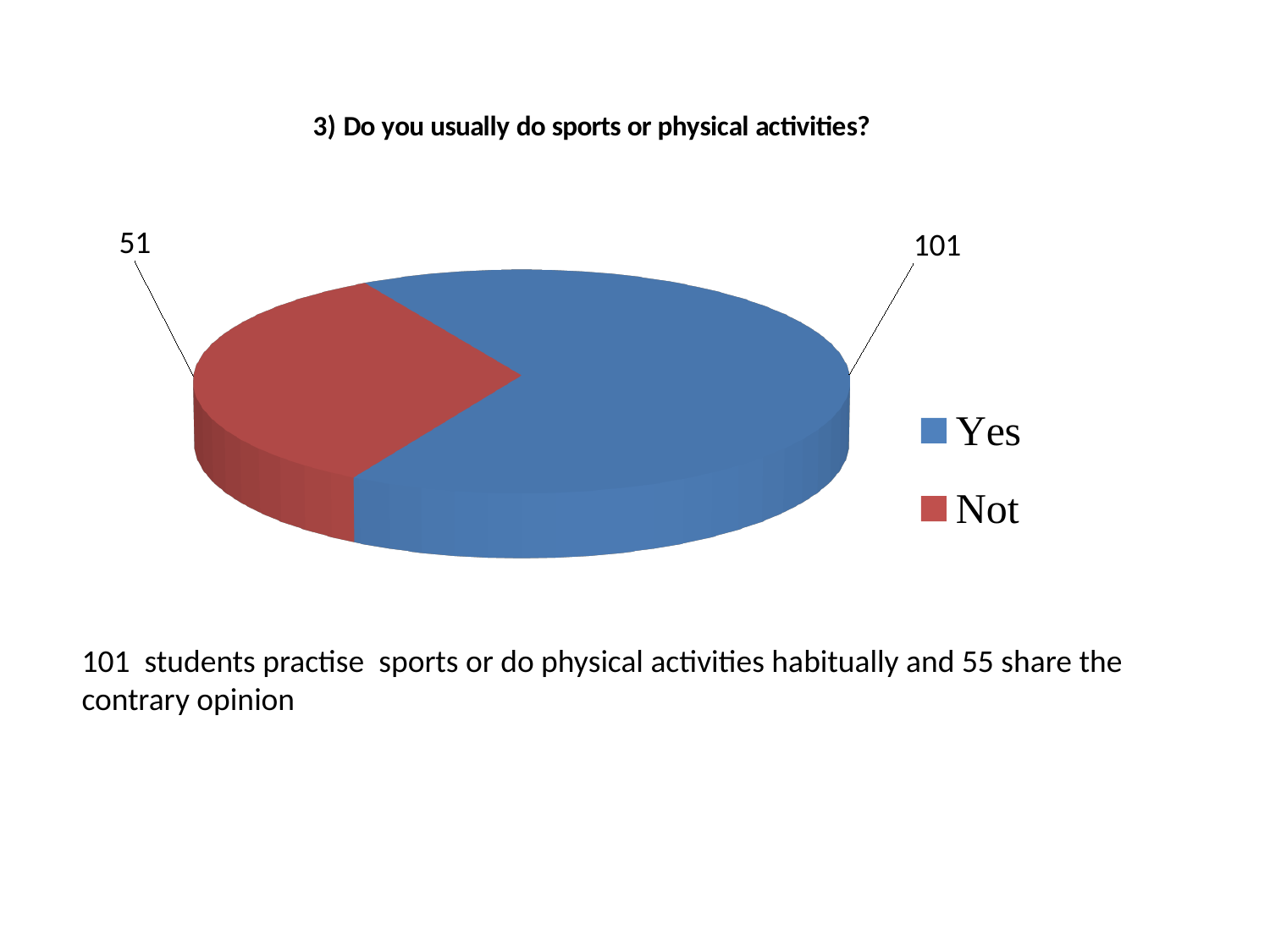
How many entries does the legend list? 2 What is the difference between the Yes value and the Not value? 50 What is the total of all slices in the pie chart? 152 What colour is the Not slice? red What kind of chart is shown on the slide? pie chart Which category has the smallest slice of the pie? Not Which category has the largest slice of the pie? Yes What is the value for the Yes slice? 101 How many slices does the pie chart have? 2 What is the title of the chart? 3) Do you usually do sports or physical activities? What is the value for the Not slice? 51 Which is larger, the Yes value or the Not value? Yes